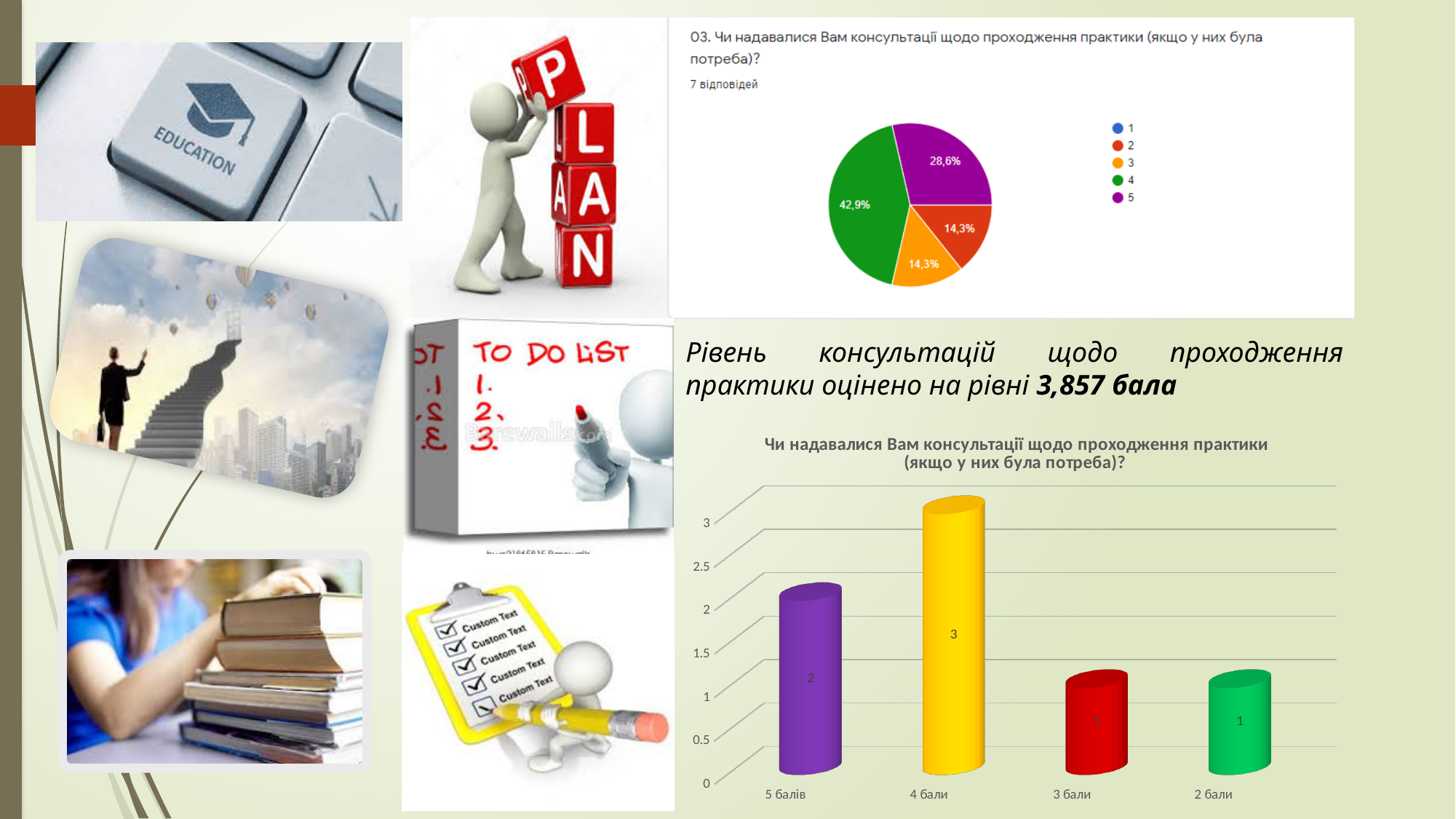
In the pie chart at the top right, what percentage is shown for the purple slice (legend entry 5)? 28,6% In the pie chart at the top right, what percentage is shown for the green slice (legend entry 4)? 42,9% How many categories are shown on the x axis of the bar chart at the bottom right? 4 In the bar chart at the bottom right, which category has the highest value? 4 бали In the bar chart at the bottom right, what is the value for "4 бали"? 3 In the bar chart at the bottom right, what is the value for "5 балів"? 2 How many entries does the legend of the pie chart at the top right list? 5 In the bar chart at the bottom right, what is the value for "3 бали"? 1 In the pie chart at the top right, which legend entry has the largest slice? 4 In the bar chart at the bottom right, what is the difference between the values for "4 бали" and "5 балів"? 1 In the bar chart at the bottom right, which is larger: the value for "5 балів" or the value for "2 бали"? 5 балів What kind of chart is the chart at the bottom right of the slide? bar chart